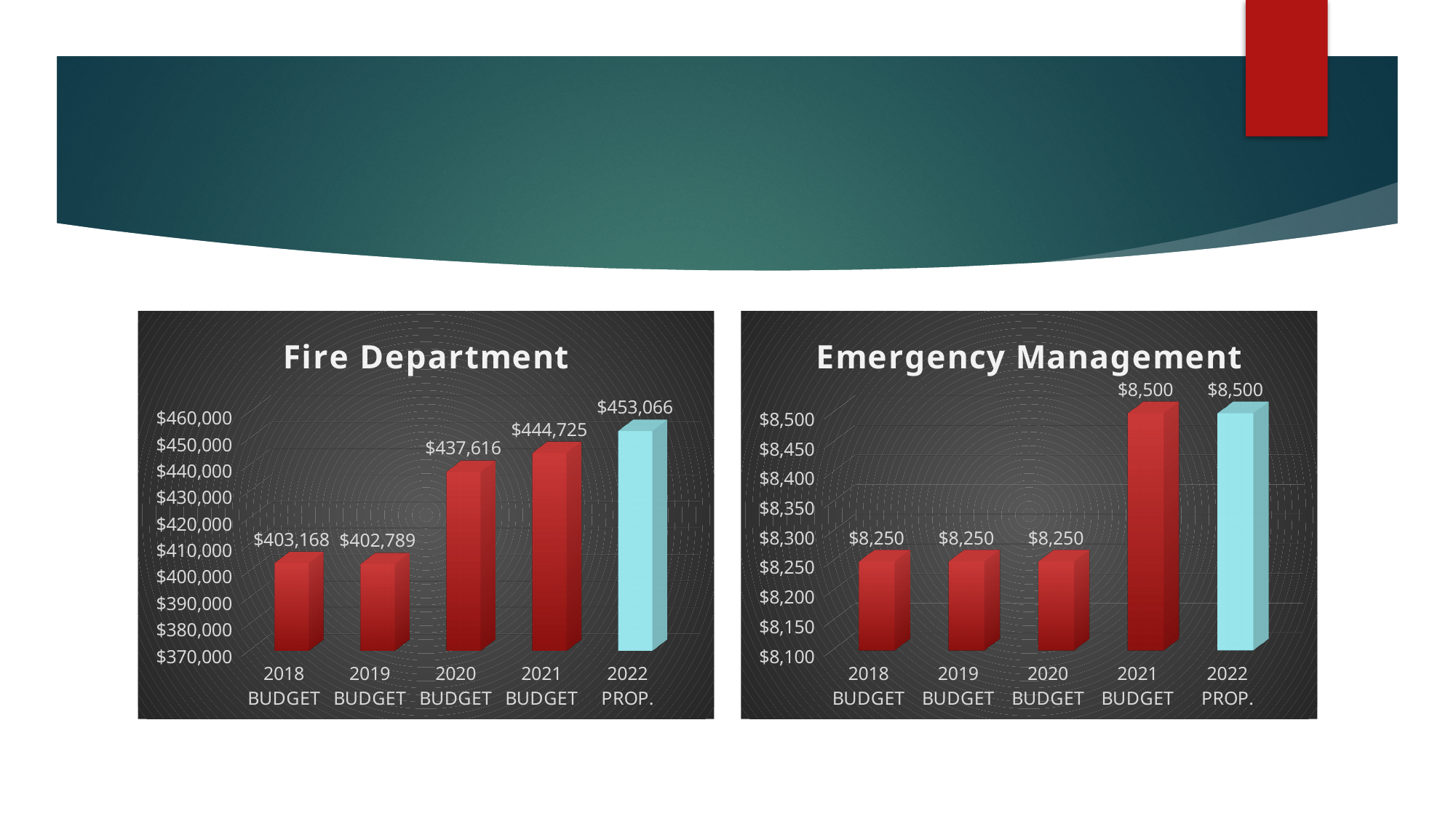
In the Emergency Management chart, which is larger, the value for 2018 BUDGET or the value for 2022 PROP.? 2022 PROP. In the Emergency Management chart, what is the value for 2019 BUDGET? $8,250 In the Fire Department chart, what is the difference between the 2022 PROP. value and the 2021 BUDGET value? $8,341 What kind of chart is the Fire Department chart? Bar chart In the Fire Department chart, is the value for 2021 BUDGET greater or less than $440,000? greater In the Fire Department chart, which category has the lowest value? 2019 BUDGET In the Fire Department chart, what is the value for 2022 PROP.? $453,066 In the Emergency Management chart, what is the difference between the 2021 BUDGET value and the 2020 BUDGET value? $250 In the Fire Department chart, do the values generally rise or fall from 2019 BUDGET to 2022 PROP.? Rise How many categories are shown in the Emergency Management chart? 5 In the Fire Department chart, what is the value for 2020 BUDGET? $437,616 In the Fire Department chart, which category has the highest value? 2022 PROP.